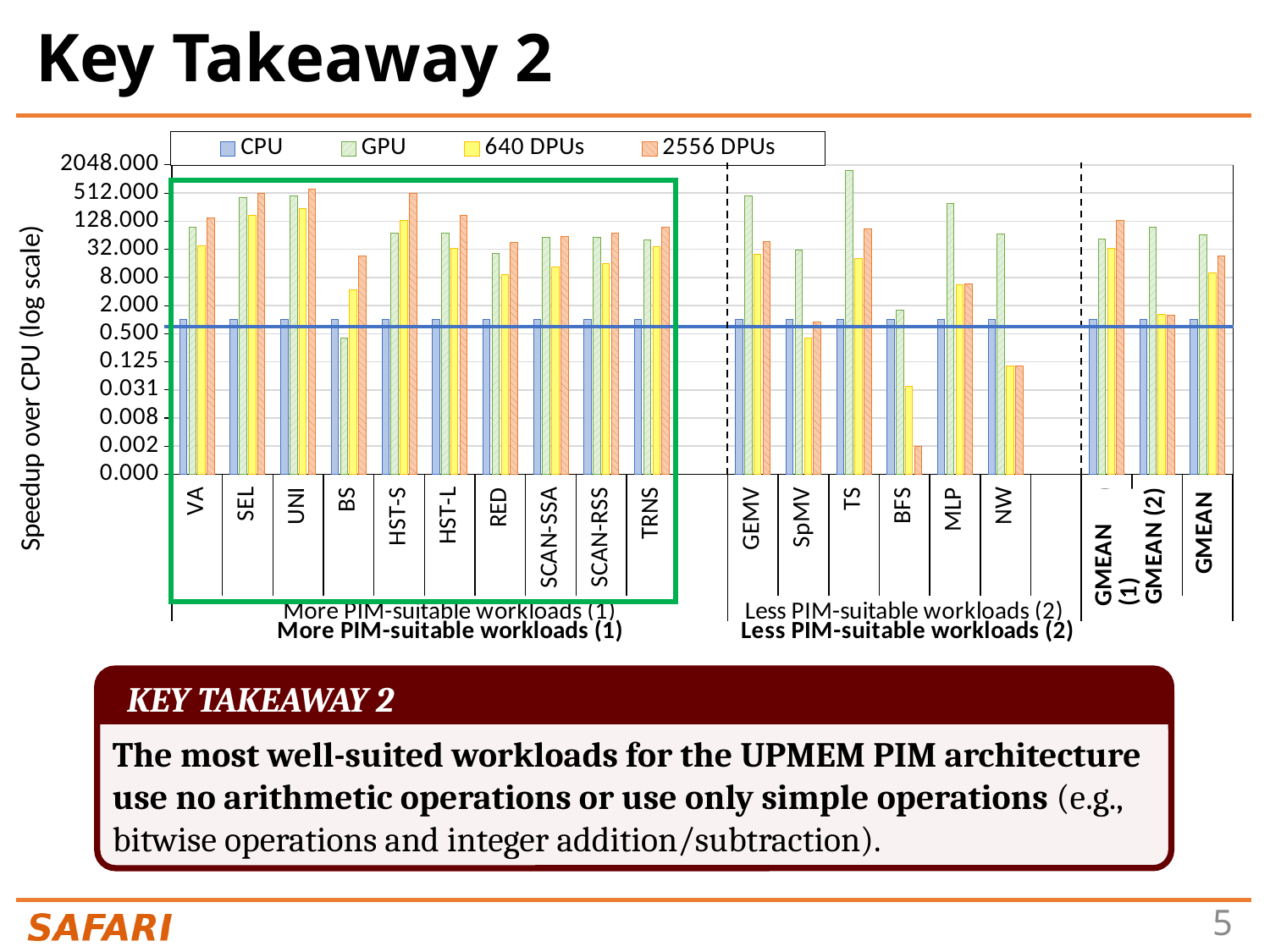
Is the 640 DPUs value for BS greater or less than 8? less Is the GPU value for TS greater or less than 512? greater How many workload categories are shown along the x axis of the chart? 19 For BS, which is larger: the 2556 DPUs value or the GPU value? 2556 DPUs How many series does the chart legend list? 4 Which series are listed in the chart legend? CPU, GPU, 640 DPUs, 2556 DPUs For TS, which is larger: the GPU value or the 640 DPUs value? GPU Which workload has the highest GPU speedup in the chart? TS Is the GPU value for BS greater or less than 0.5? less What kind of chart is shown on the slide? bar chart